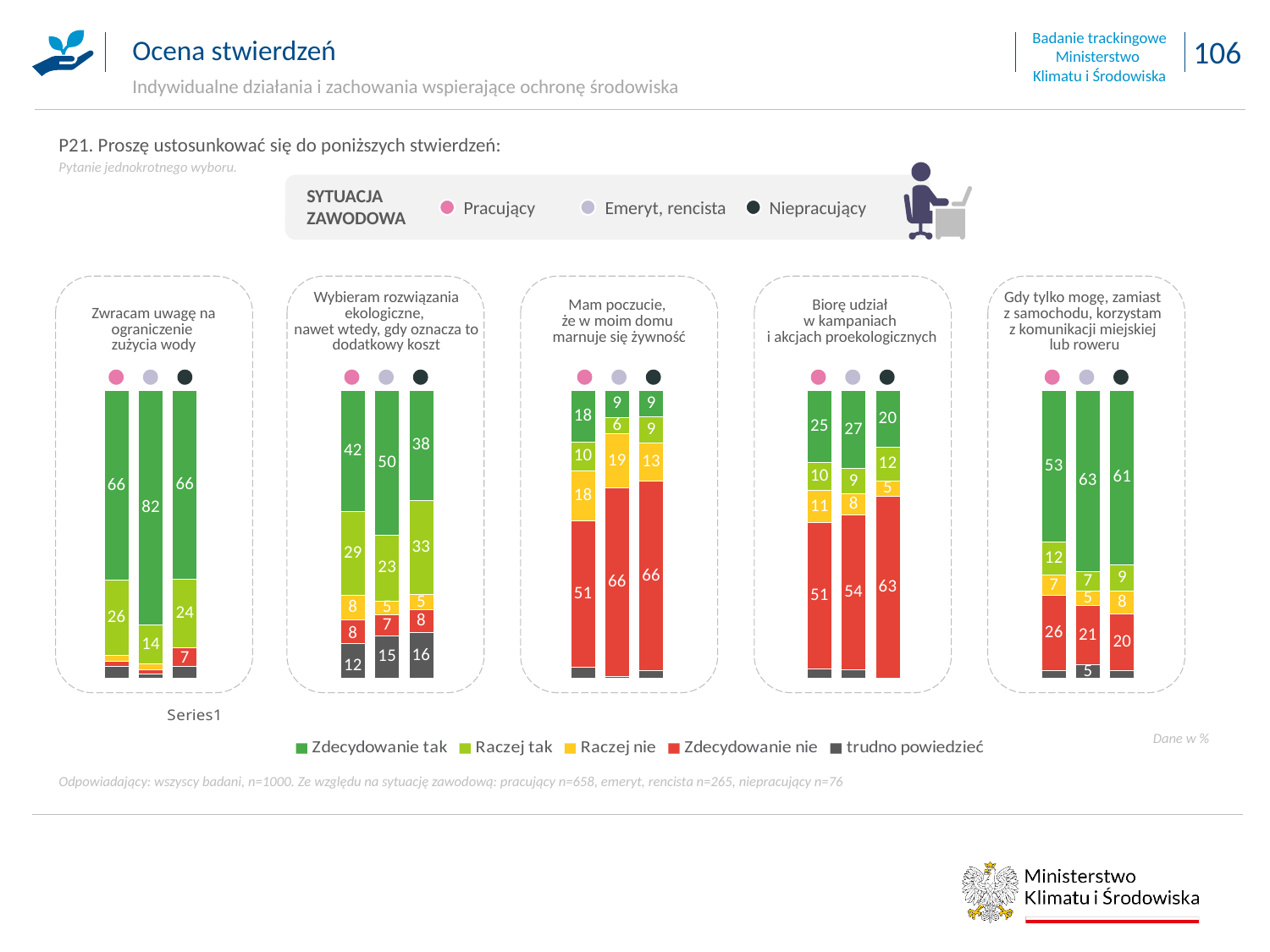
What type of chart is used on this slide? Stacked bar chart In the chart 'Biorę udział w kampaniach i akcjach proekologicznych', what is the 'Zdecydowanie tak' value for Niepracujący? 20 In the chart 'Zwracam uwagę na ograniczenie zużycia wody', which group has the highest 'Zdecydowanie tak' value? Emeryt, rencista In the chart 'Mam poczucie, że w moim domu marnuje się żywność', what is the 'Zdecydowanie nie' value for Pracujący? 51 In the chart 'Gdy tylko mogę, zamiast z samochodu, korzystam z komunikacji miejskiej lub roweru', what is the 'Zdecydowanie tak' value for Emeryt, rencista? 63 In the chart 'Zwracam uwagę na ograniczenie zużycia wody', what is the 'Zdecydowanie tak' value for Emeryt, rencista? 82 In the chart 'Wybieram rozwiązania ekologiczne, nawet wtedy, gdy oznacza to dodatkowy koszt', what is the 'trudno powiedzieć' value for Niepracujący? 16 In the chart 'Biorę udział w kampaniach i akcjach proekologicznych', which is larger: the 'Zdecydowanie nie' value for Niepracujący or for Pracujący? Niepracujący In the chart 'Mam poczucie, że w moim domu marnuje się żywność', what is the difference between the 'Zdecydowanie nie' values for Emeryt, rencista and Pracujący? 15 In the chart 'Wybieram rozwiązania ekologiczne, nawet wtedy, gdy oznacza to dodatkowy koszt', which group has the lowest 'Zdecydowanie tak' value? Niepracujący How many bars are shown in the chart 'Gdy tylko mogę, zamiast z samochodu, korzystam z komunikacji miejskiej lub roweru'? 3 How many series does the legend at the bottom of the slide list? 5